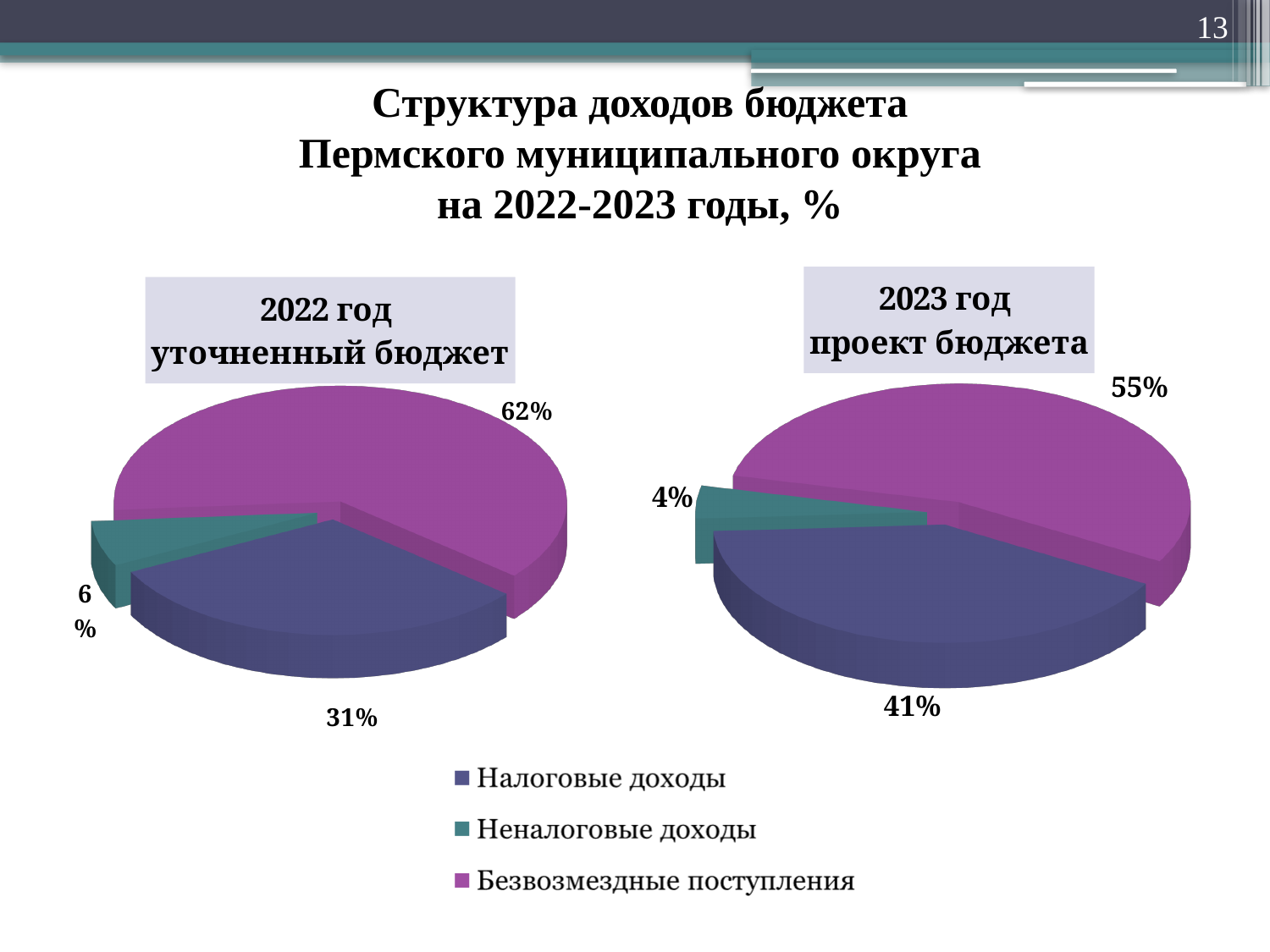
In the '2022 год уточненный бюджет' chart, what share is shown for Налоговые доходы? 31% In the '2023 год проект бюджета' chart, which category has the largest share? Безвозмездные поступления In the '2022 год уточненный бюджет' chart, which category has the smallest share? Неналоговые доходы In the '2023 год проект бюджета' chart, what share is shown for Безвозмездные поступления? 55% In the '2022 год уточненный бюджет' chart, what share is shown for Безвозмездные поступления? 62% What is the difference between the share of Налоговые доходы in the '2023 год проект бюджета' chart and in the '2022 год уточненный бюджет' chart? 10% What type of chart is used on this slide? Pie chart How many categories does the legend list? 3 In the '2023 год проект бюджета' chart, what share is shown for Налоговые доходы? 41% Which is larger: the share of Безвозмездные поступления in the '2022 год уточненный бюджет' chart or in the '2023 год проект бюджета' chart? 2022 год уточненный бюджет In the '2022 год уточненный бюджет' chart, what share is shown for Неналоговые доходы? 6% In the '2023 год проект бюджета' chart, what share is shown for Неналоговые доходы? 4%